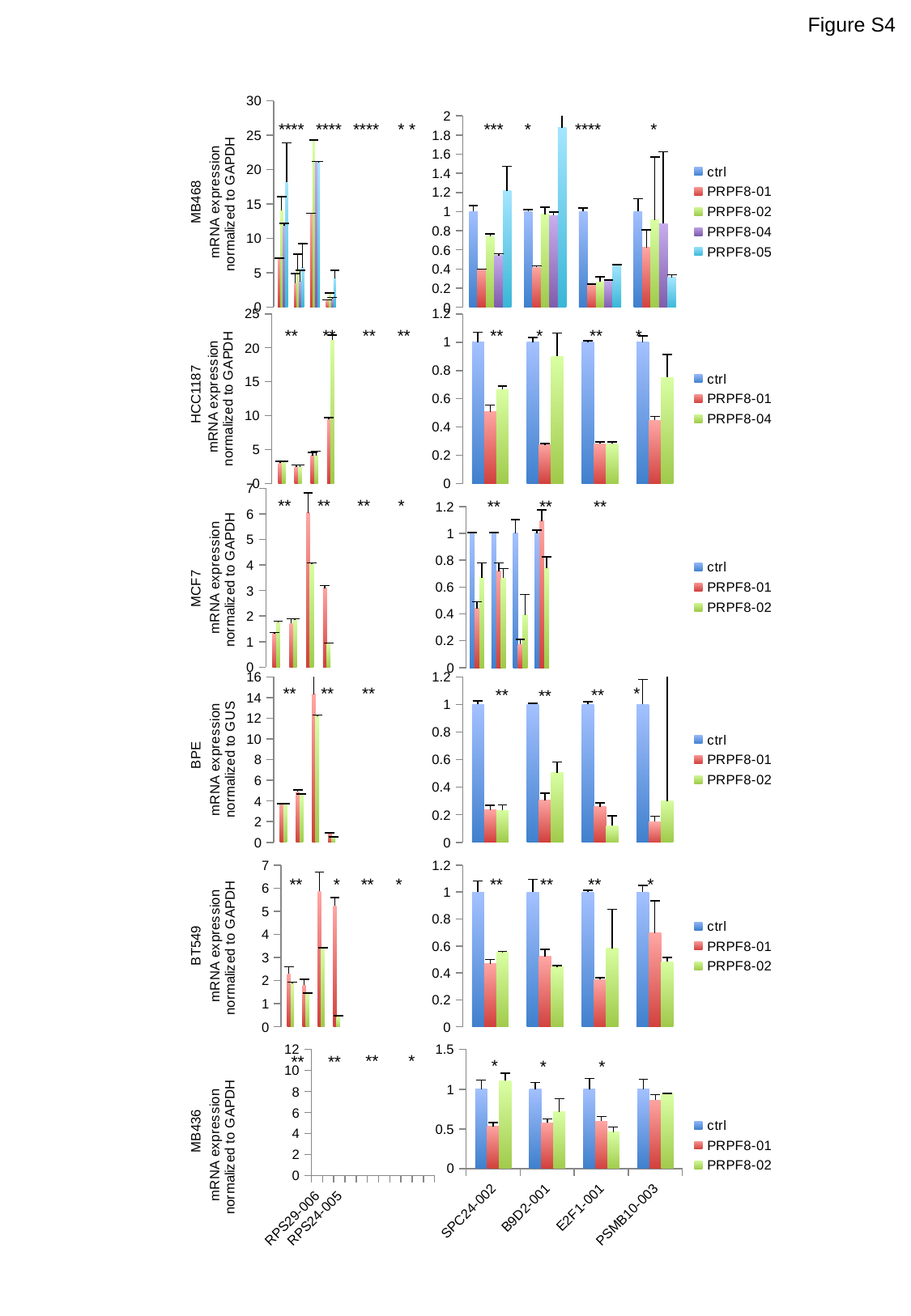
In the MB436 right-hand chart, which is larger at E2F1-001: ctrl or PRPF8-02? ctrl In the HCC1187 right-hand chart, is the value for PRPF8-01 at B9D2-001 greater or less than 0.4? less In the BPE right-hand chart, which series has the highest bar for SPC24-002? ctrl In the MB468 right-hand chart, which series has the highest bar for B9D2-001? PRPF8-05 What kind of chart is used in the MB468 row on the right side of the slide? bar chart In the BT549 right-hand chart, is the value for PRPF8-02 at SPC24-002 greater or less than 0.4? greater In the BPE right-hand chart, is the value for PRPF8-01 at SPC24-002 greater or less than 0.4? less How many series does the legend list for the MB468 charts? 5 How many series does the legend list for the HCC1187 charts? 3 How many categories are shown on the x axis of the right-hand charts (SPC24-002 through PSMB10-003)? 4 What is the y-axis label of the BPE charts? mRNA expression normalized to GUS